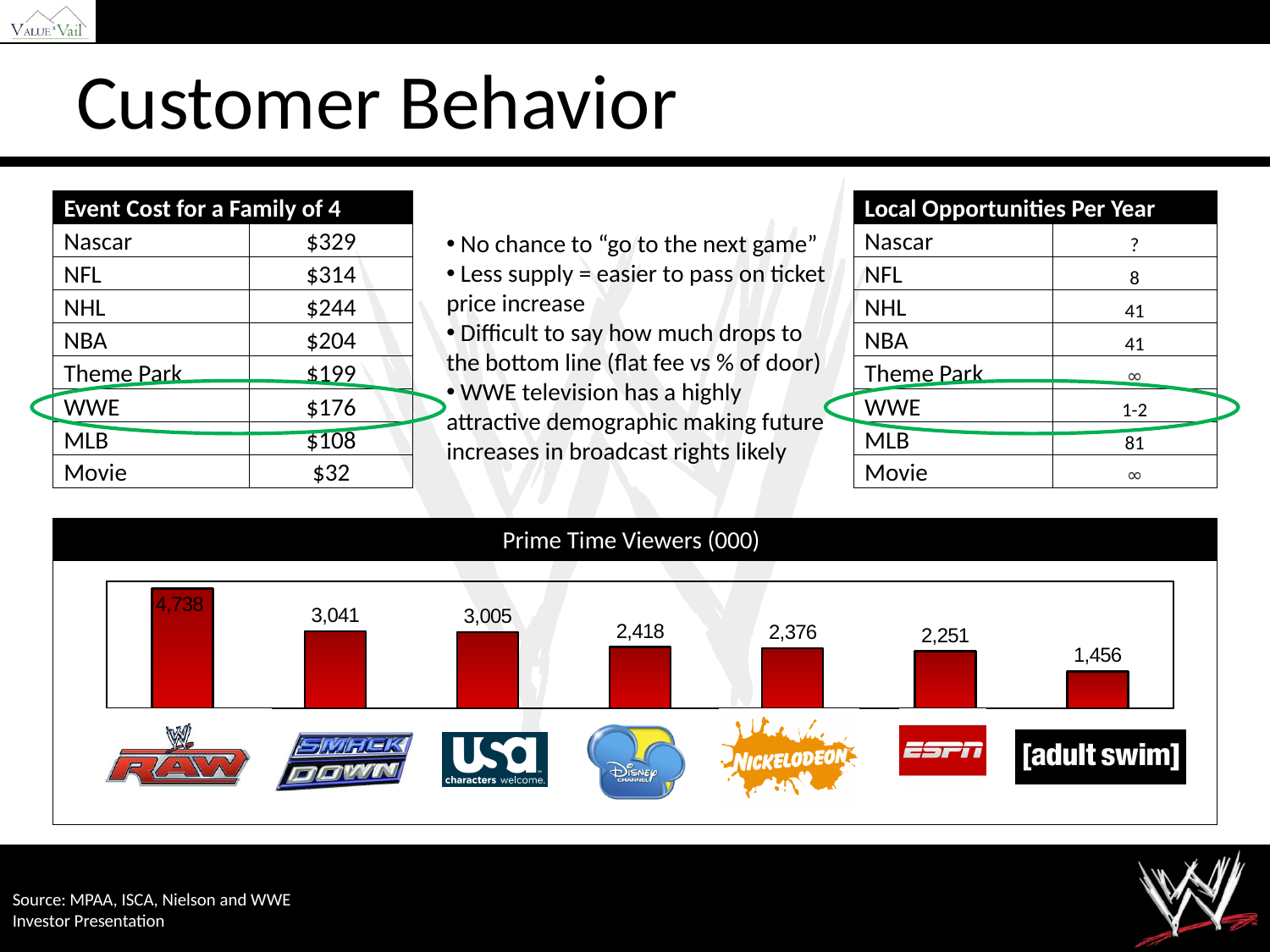
How many bars are plotted in the Prime Time Viewers (000) chart? 7 In the Prime Time Viewers (000) chart, what is the value for the Adult Swim bar? 1,456 In the Prime Time Viewers (000) chart, which bar has the lowest value? Adult Swim In the Prime Time Viewers (000) chart, what is the difference between the RAW value and the SmackDown value? 1,697 In the Prime Time Viewers (000) chart, which bar has the highest value? RAW What kind of chart is the Prime Time Viewers (000) chart? Bar chart In the Prime Time Viewers (000) chart, what is the value for the SmackDown bar? 3,041 Do the values in the Prime Time Viewers (000) chart rise or fall from left to right? Fall In the Prime Time Viewers (000) chart, which is larger, the ESPN value or the Adult Swim value? ESPN In the Prime Time Viewers (000) chart, what is the value for the RAW bar? 4,738 In the Prime Time Viewers (000) chart, what is the value for the USA bar? 3,005 In the Prime Time Viewers (000) chart, what is the difference between the Disney Channel value and the Nickelodeon value? 42